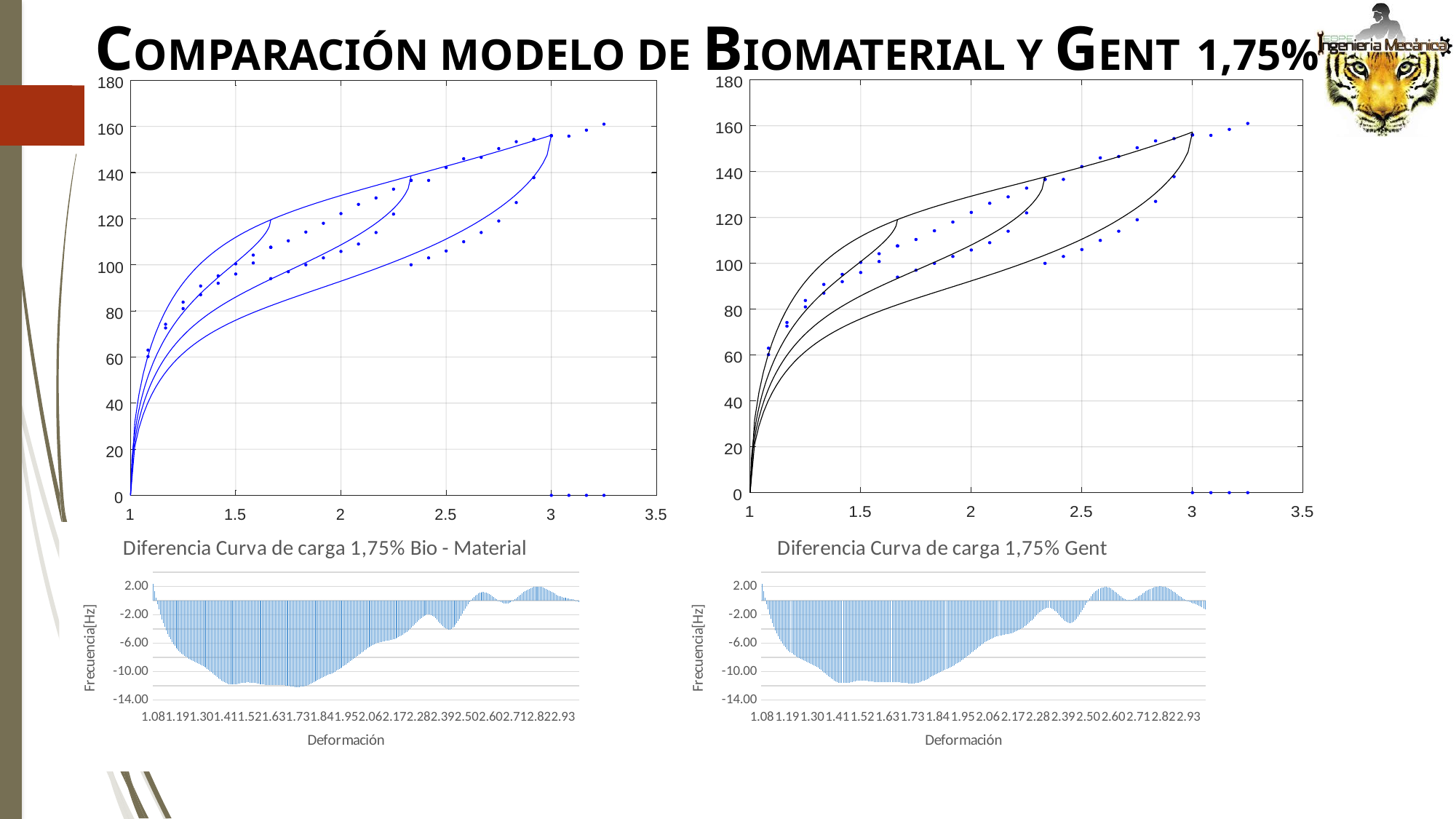
In the bottom-left chart 'Diferencia Curva de carga 1,75% Bio - Material', is the value at deformation 2.93 greater or less than -6.00? greater In the top-left chart with the blue curves, is the value of the outer curve at x = 3 greater or less than 140? greater In the bottom-right chart 'Diferencia Curva de carga 1,75% Gent', is the value at deformation 1.73 greater or less than -10.00? less In the bottom-left chart 'Diferencia Curva de carga 1,75% Bio - Material', do the values rise or fall between deformation 1.08 and 1.63? fall In the bottom-right chart 'Diferencia Curva de carga 1,75% Gent', do the values rise or fall between deformation 1.84 and 2.50? rise What is the y-axis label of the bottom-left chart 'Diferencia Curva de carga 1,75% Bio - Material'? Frecuencia[Hz] What is the title of the bottom-right chart? Diferencia Curva de carga 1,75% Gent What kind of chart is the top-left chart with the blue curves? Line chart How many charts are shown on the slide? 4 What kind of chart is the bottom-left chart titled 'Diferencia Curva de carga 1,75% Bio - Material'? Bar chart